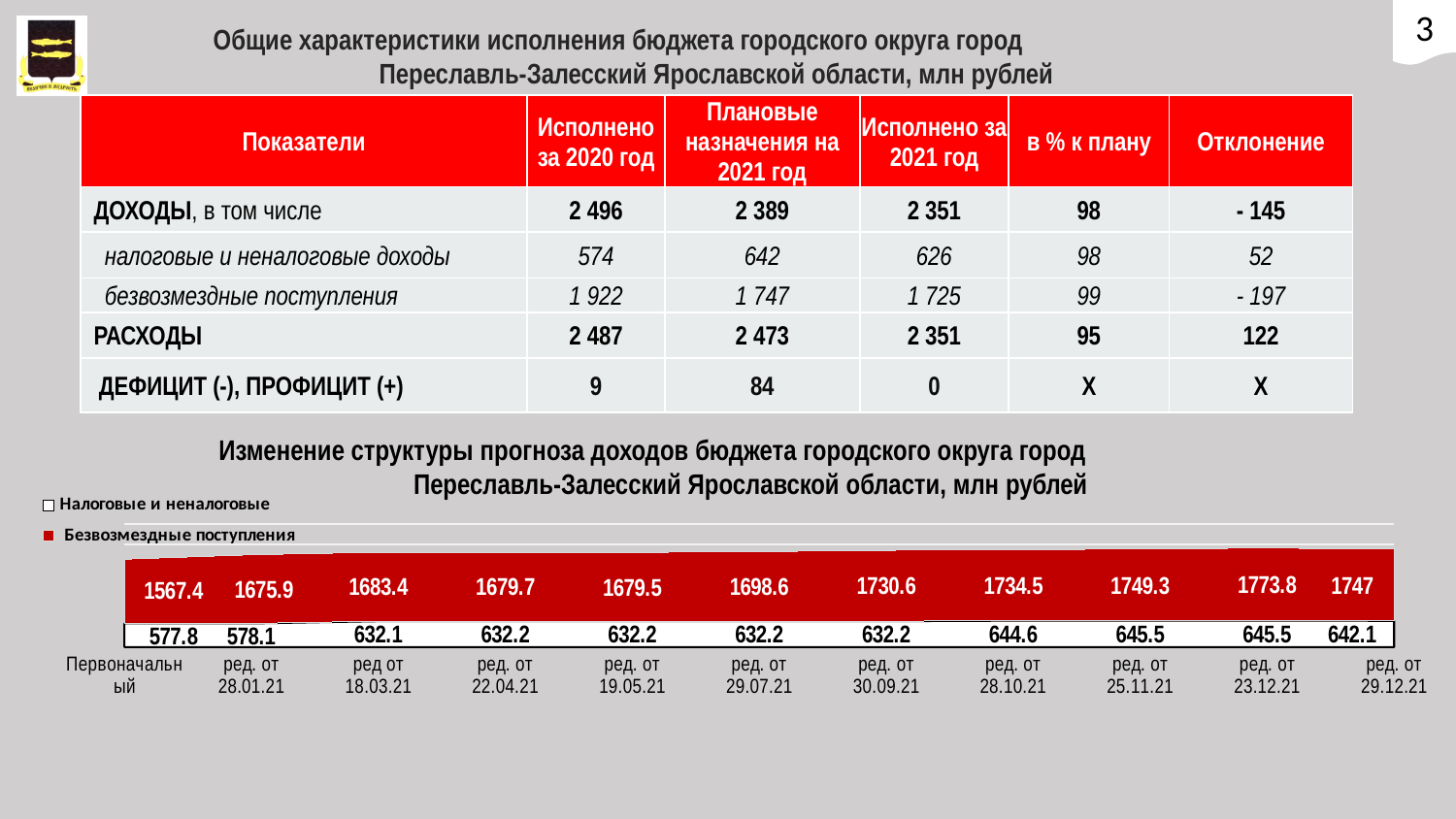
In the bottom chart, what is the value of Безвозмездные поступления for Первоначальный? 1567.4 In the bottom chart, what is the difference between the Безвозмездные поступления values for ред. от 23.12.21 and Первоначальный? 206.4 In the bottom chart, which is larger: Безвозмездные поступления for ред. от 23.12.21 or for ред. от 29.12.21? ред. от 23.12.21 In the bottom chart, which colour represents Безвозмездные поступления? red What type of chart is shown at the bottom of the slide? stacked area chart In the bottom chart, what is the value of Безвозмездные поступления for ред. от 30.09.21? 1730.6 How many series does the legend of the bottom chart list? 2 How many categories are shown along the x axis of the bottom chart? 11 In the bottom chart, which category has the lowest value for Налоговые и неналоговые? Первоначальный In the bottom chart, which category has the highest value for Безвозмездные поступления? ред. от 23.12.21 In the bottom chart, what is the value of Налоговые и неналоговые for ред. от 29.12.21? 642.1